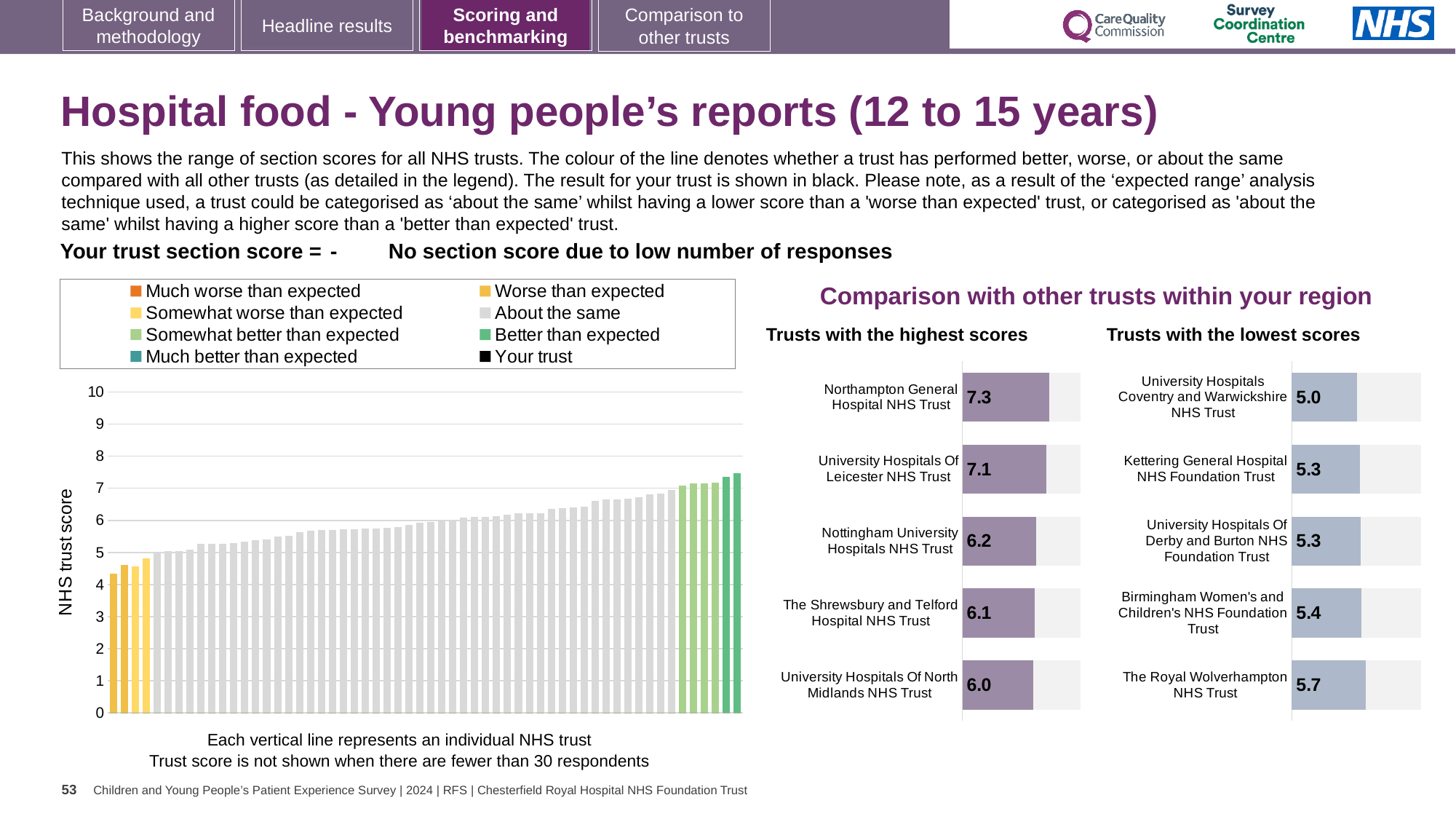
In the 'Trusts with the lowest scores' chart, which trust has the lowest score? University Hospitals Coventry and Warwickshire NHS Trust In the 'Trusts with the highest scores' chart, what is the difference between the scores of Northampton General Hospital NHS Trust and University Hospitals Of North Midlands NHS Trust? 1.3 In the main 'NHS trust score' chart, is the value of the rightmost bar greater or less than 7? greater In the main 'NHS trust score' chart, is the value of the leftmost bar greater or less than 5? less In the 'Trusts with the highest scores' chart, what is the score for Northampton General Hospital NHS Trust? 7.3 In the 'Trusts with the highest scores' chart, what is the score for Nottingham University Hospitals NHS Trust? 6.2 In the 'Trusts with the highest scores' chart, which trust has the highest score? Northampton General Hospital NHS Trust In the main 'NHS trust score' chart, do the bar values rise or fall from left to right? rise In the 'Trusts with the lowest scores' chart, which has the higher score: Kettering General Hospital NHS Foundation Trust or Birmingham Women's and Children's NHS Foundation Trust? Birmingham Women's and Children's NHS Foundation Trust How many trusts are shown in the 'Trusts with the lowest scores' chart? 5 In the 'Trusts with the lowest scores' chart, what is the score for The Royal Wolverhampton NHS Trust? 5.7 How many entries does the legend above the main 'NHS trust score' chart list? 8